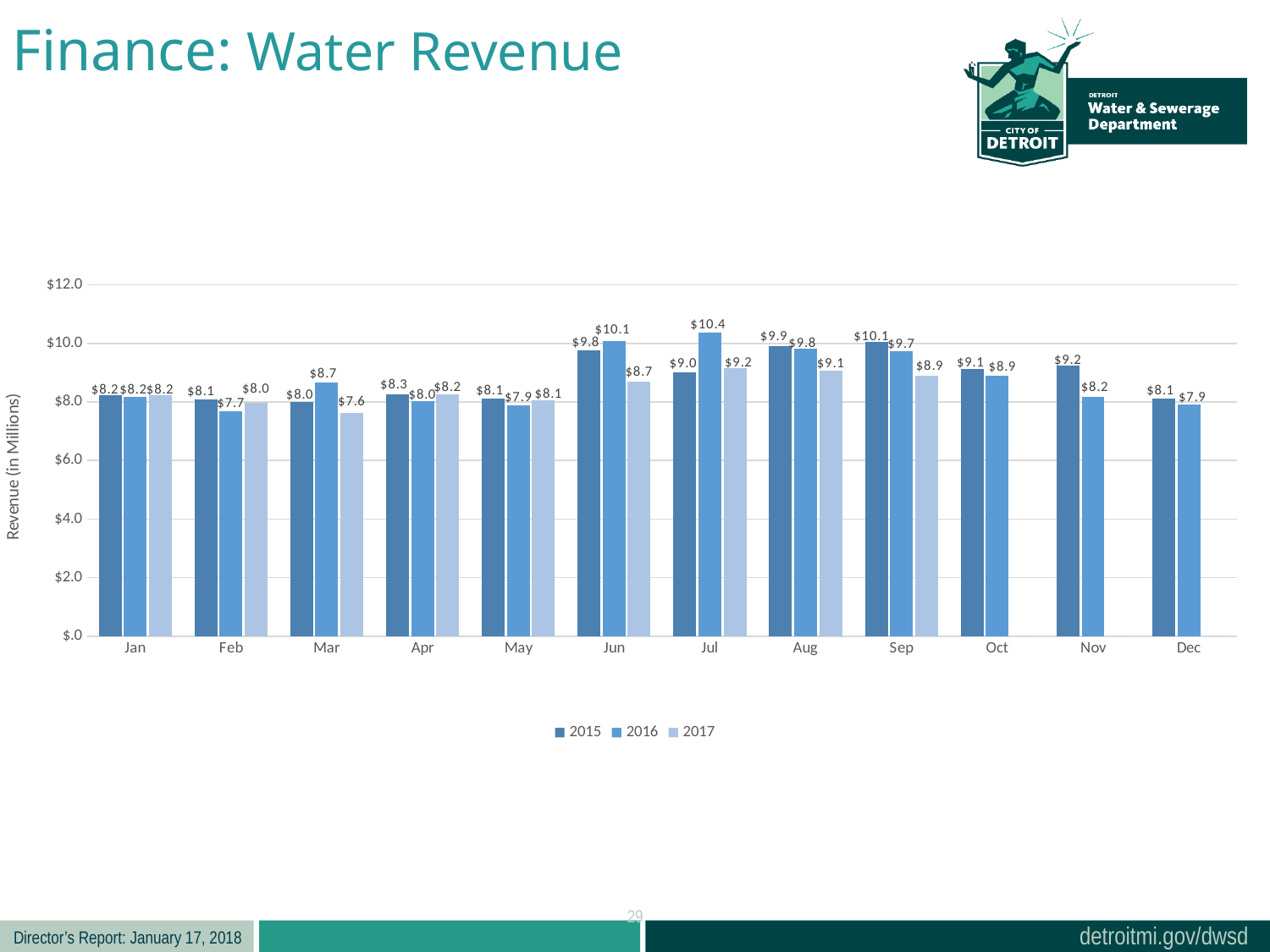
What was the water revenue for 2017 in June? $8.7 In which month was the 2017 water revenue lowest? Mar In which month was the 2016 water revenue highest? Jul What was the water revenue for 2015 in November? $9.2 How many series does the legend list? 3 What is the difference between the 2016 and 2017 water revenue in July? $1.2 What is the label of the y axis? Revenue (in Millions) What type of chart is shown on the slide? bar chart Which was larger in March, the 2016 or the 2017 water revenue? 2016 How many months are shown on the x axis? 12 What was the water revenue for 2015 in September? $10.1 What was the water revenue for 2016 in July? $10.4